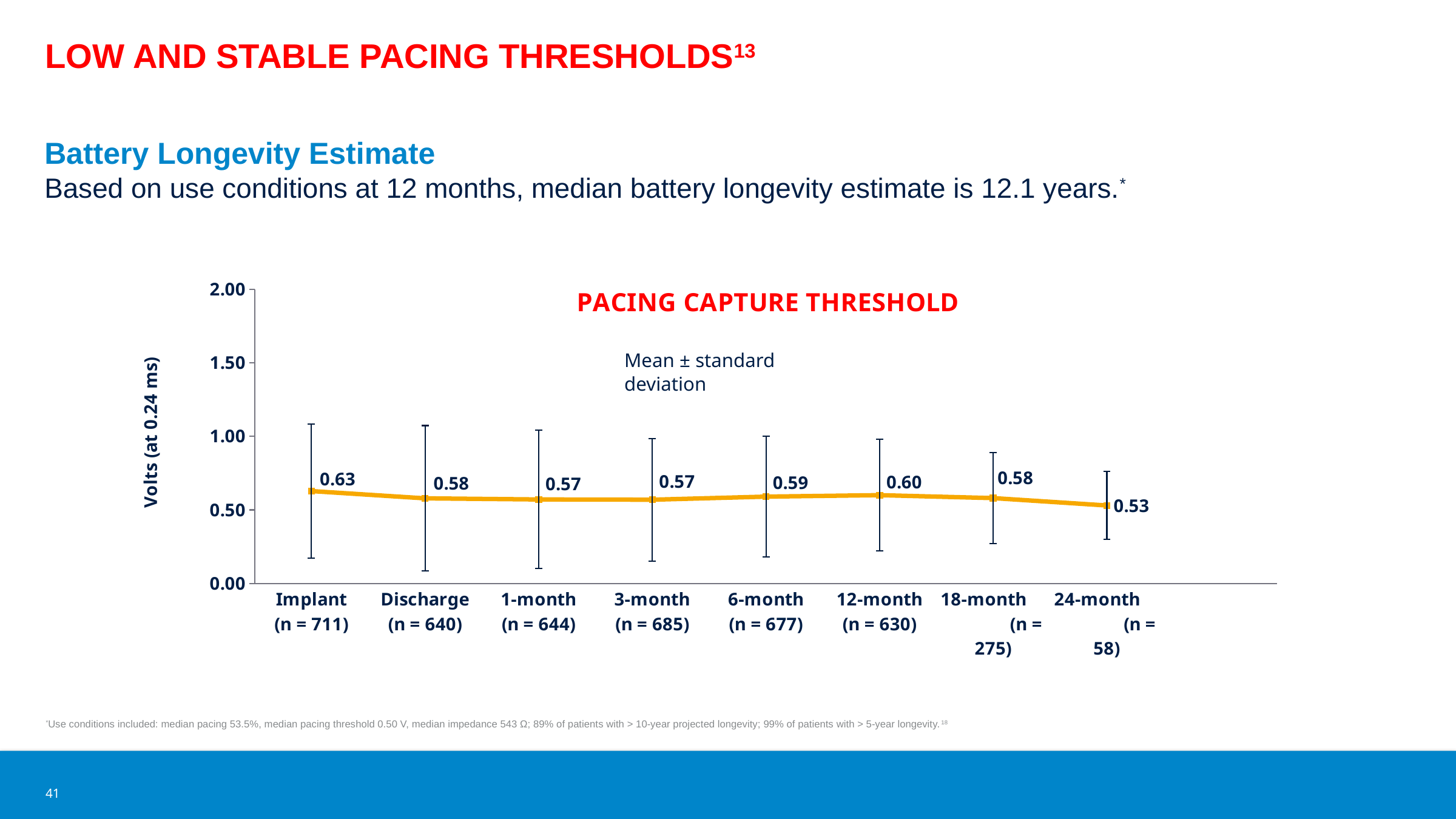
What kind of chart is used to show the pacing capture threshold? line chart At which time point is the mean pacing capture threshold lowest? 24-month What is the difference between the mean pacing capture threshold at Implant and at 24-month? 0.10 What is the number of patients (n) at the 18-month time point? 275 Which has a higher mean pacing capture threshold, Implant or Discharge? Implant What is the mean pacing capture threshold at 12-month? 0.60 At which time point is the mean pacing capture threshold highest? Implant What is the mean pacing capture threshold at 24-month? 0.53 What is the label of the y axis on the chart? Volts (at 0.24 ms) What is the mean pacing capture threshold at Implant? 0.63 How many time points are plotted on the pacing capture threshold chart? 8 Is the mean pacing capture threshold at 6-month greater or less than 1.00? less